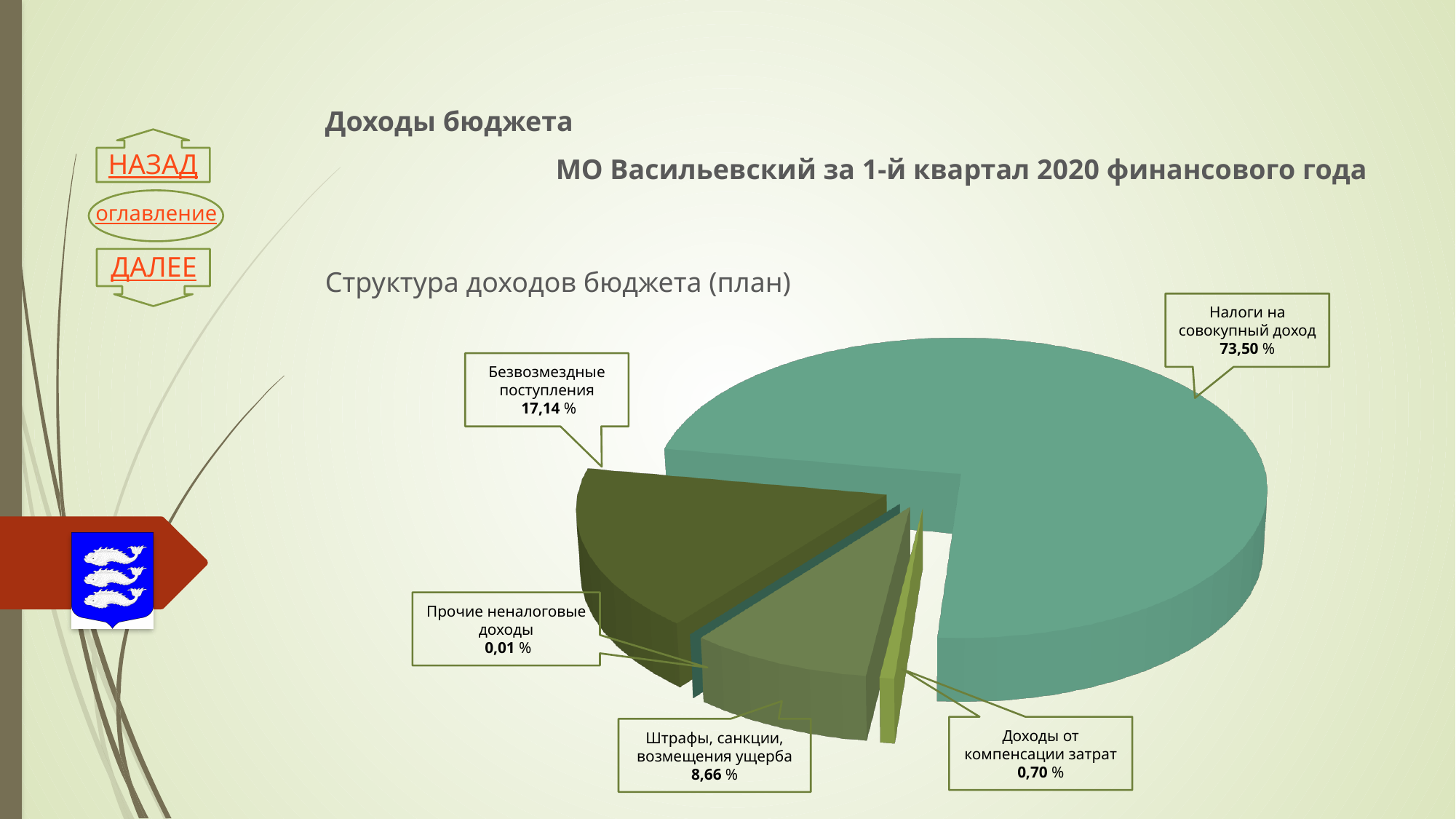
What type of chart is shown on the slide? Pie chart Which category has the smallest share of the pie? Прочие неналоговые доходы What value is shown for Доходы от компенсации затрат? 0,70 % What value is shown for Прочие неналоговые доходы? 0,01 % What value is shown for Штрафы, санкции, возмещения ущерба? 8,66 % How many slices does the pie chart have? 5 Which category has the largest share of the pie? Налоги на совокупный доход What share of the pie is labelled for Налоги на совокупный доход? 73,50 % Which is larger: the share of Штрафы, санкции, возмещения ущерба or the share of Доходы от компенсации затрат? Штрафы, санкции, возмещения ущерба What value is shown for Безвозмездные поступления? 17,14 % What is the difference between the shares of Налоги на совокупный доход and Безвозмездные поступления? 56,36 % What is the title of the chart? Структура доходов бюджета (план)